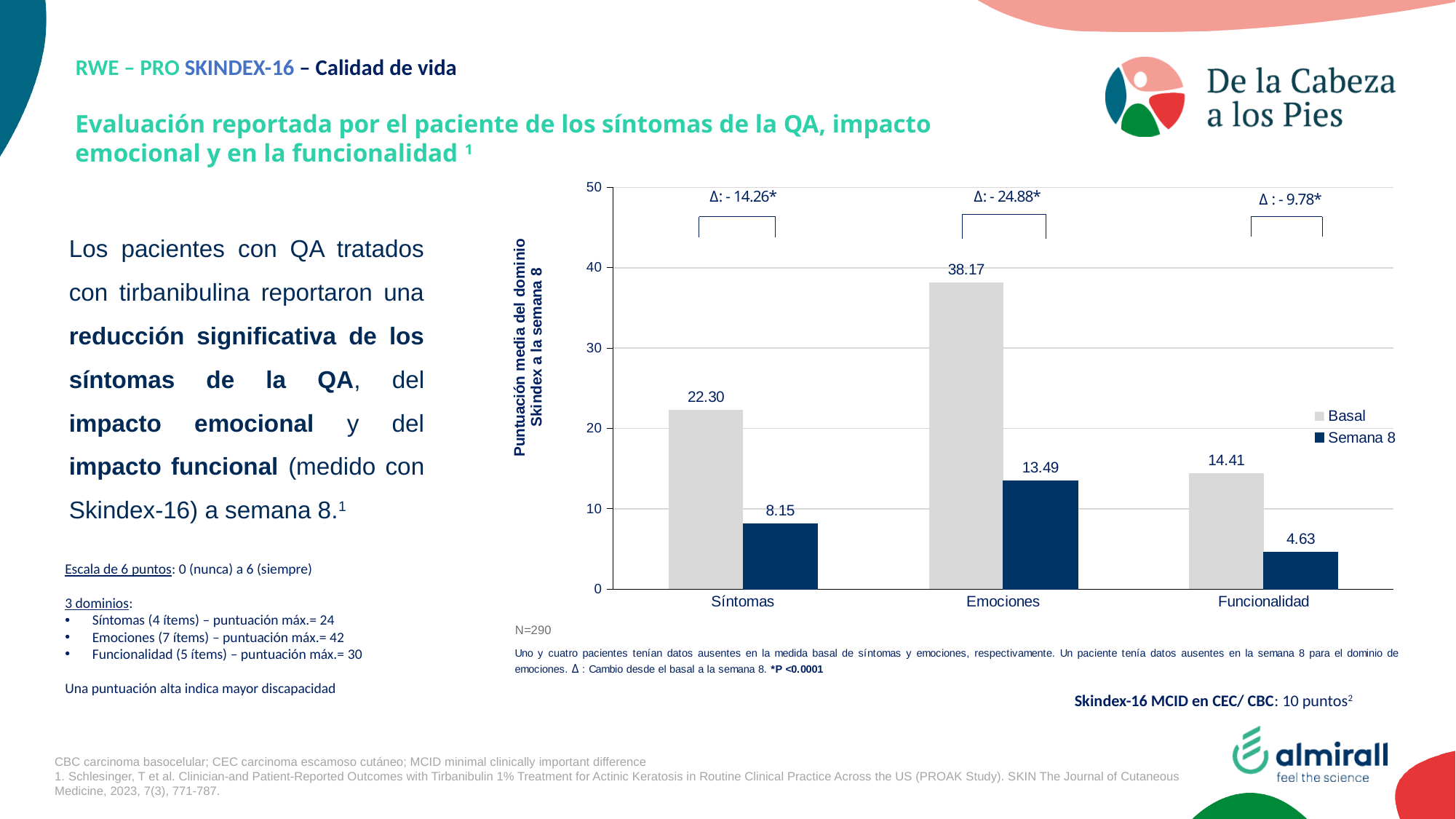
What is the y-axis label of the chart? Puntuación media del dominio Skindex a la semana 8 Which category has the lowest Semana 8 value? Funcionalidad What is the Semana 8 value for Síntomas? 8.15 What is the Basal value for Emociones? 38.17 Is the Basal value for Síntomas greater or less than 20? greater Which is larger, the Basal value for Funcionalidad or the Semana 8 value for Emociones? Basal value for Funcionalidad What is the Semana 8 value for Funcionalidad? 4.63 How many categories are shown on the x axis? 3 What kind of chart is shown on the slide? Bar chart What is the difference between the Basal and Semana 8 values for Síntomas? 14.15 How many series does the legend list? 2 Which category has the highest Basal value? Emociones